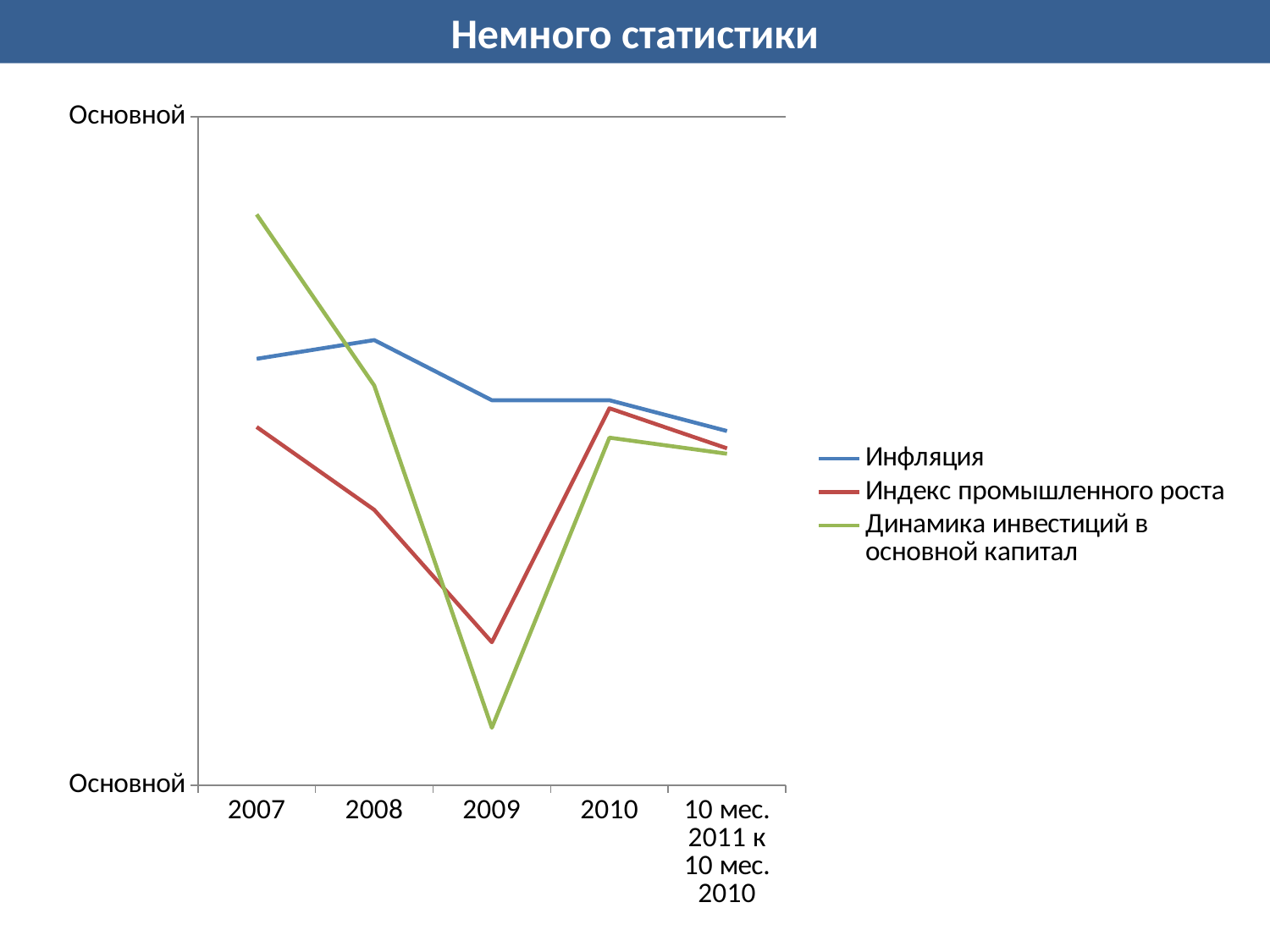
What kind of chart is shown on the slide? line chart In which year does the Инфляция series reach its highest point? 2008 In which year does the Индекс промышленного роста series reach its lowest point? 2009 In which year does the Динамика инвестиций в основной капитал series reach its lowest point? 2009 Which series has the lowest value in 2007? Индекс промышленного роста Does the Динамика инвестиций в основной капитал series rise or fall from 2007 to 2009? fall Which series has the highest value in 2007? Динамика инвестиций в основной капитал How many categories are shown along the x axis? 5 What is the title of the slide? Немного статистики In 2009, which is higher: Инфляция or Индекс промышленного роста? Инфляция Does the Инфляция series rise or fall from 2008 to 2010? fall How many series does the legend list? 3